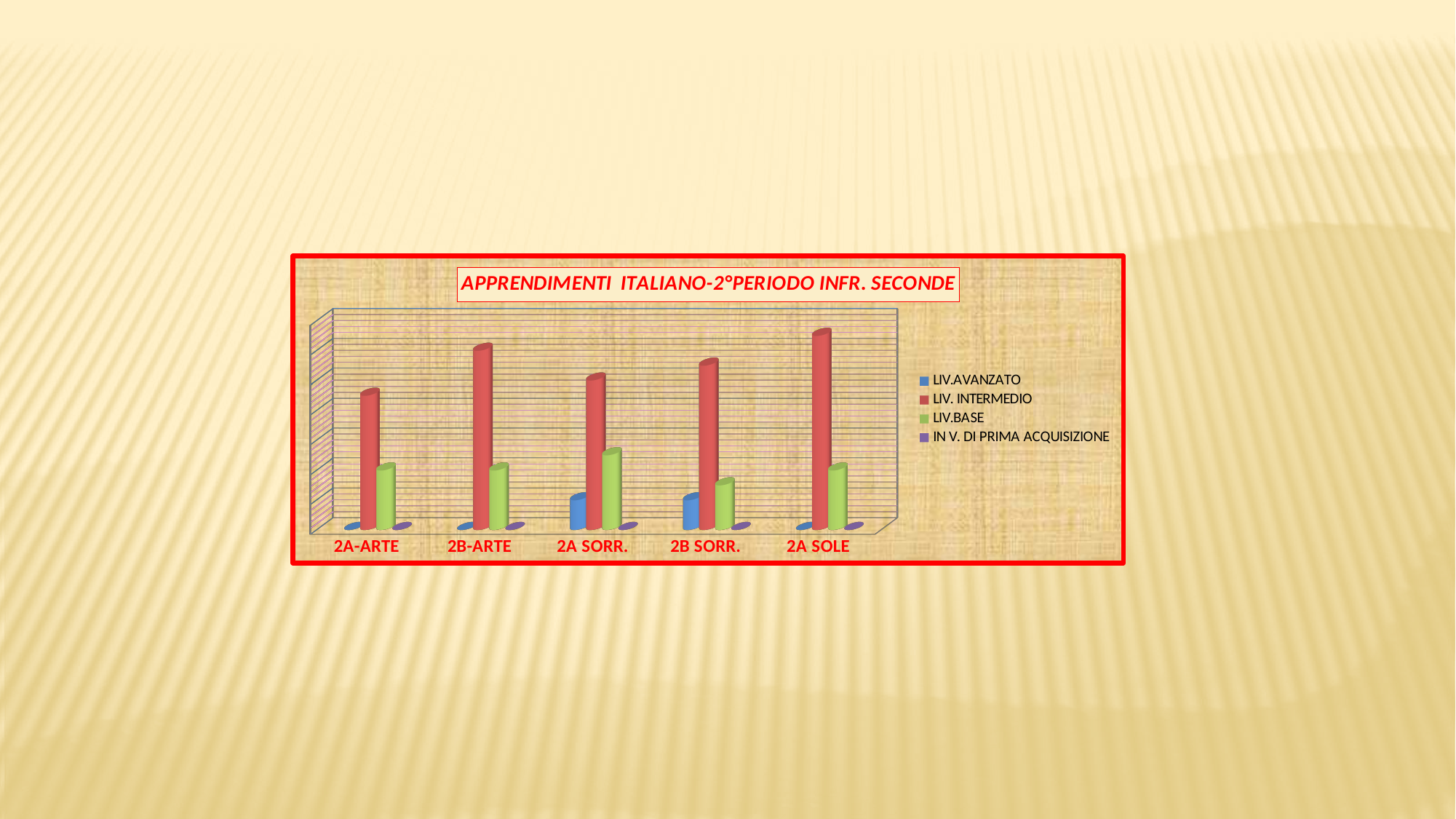
How many categories (classes) are shown on the x axis? 5 How many series does the legend list? 4 Which category has the lowest LIV. INTERMEDIO bar? 2A-ARTE What is the title of the chart? APPRENDIMENTI ITALIANO-2°PERIODO INFR. SECONDE Which has the larger LIV. INTERMEDIO value: 2A SOLE or 2B-ARTE? 2A SOLE What kind of chart is shown on the slide? Bar chart Which has the larger LIV. INTERMEDIO value: 2A SORR. or 2B SORR.? 2B SORR. Which category has the highest LIV.BASE bar? 2A SORR. Which is larger for 2A SORR.: LIV.AVANZATO or LIV.BASE? LIV.BASE Which category has the highest LIV. INTERMEDIO bar? 2A SOLE Which colour represents the LIV. INTERMEDIO series in the legend? Red